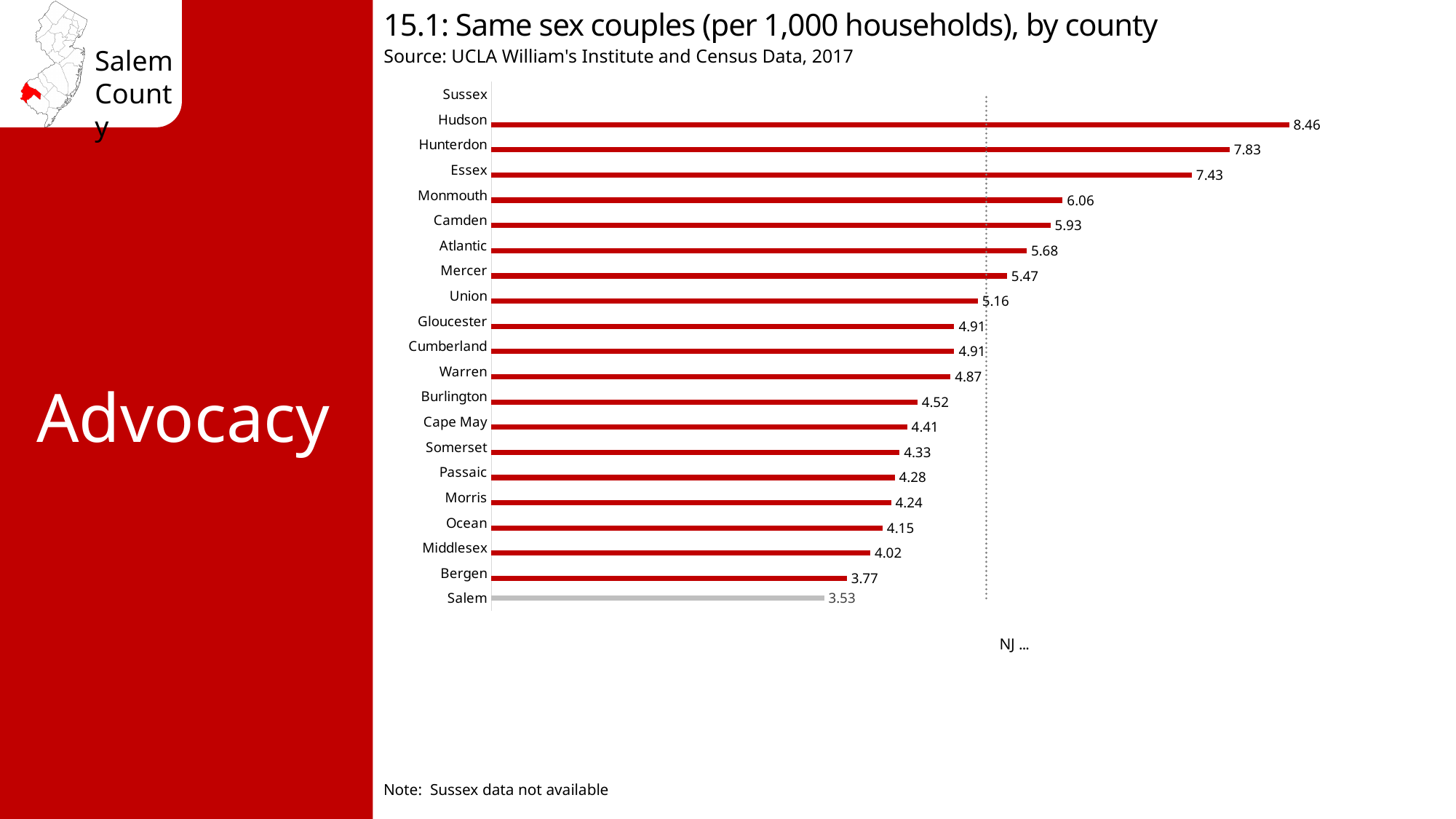
Which county with a plotted bar has the lowest value? Salem What is the difference between the values for Hudson and Salem? 4.93 Which county's bar is drawn in grey rather than red? Salem What is the value for Salem? 3.53 According to the note, which county's data is not available? Sussex What is the value for Camden? 5.93 How many counties are listed on the vertical axis? 21 What is the difference between the values for Hunterdon and Essex? 0.40 What is the value for Hudson? 8.46 Which county has the highest value? Hudson What kind of chart is shown? bar chart Which is larger, the value for Monmouth or the value for Mercer? Monmouth